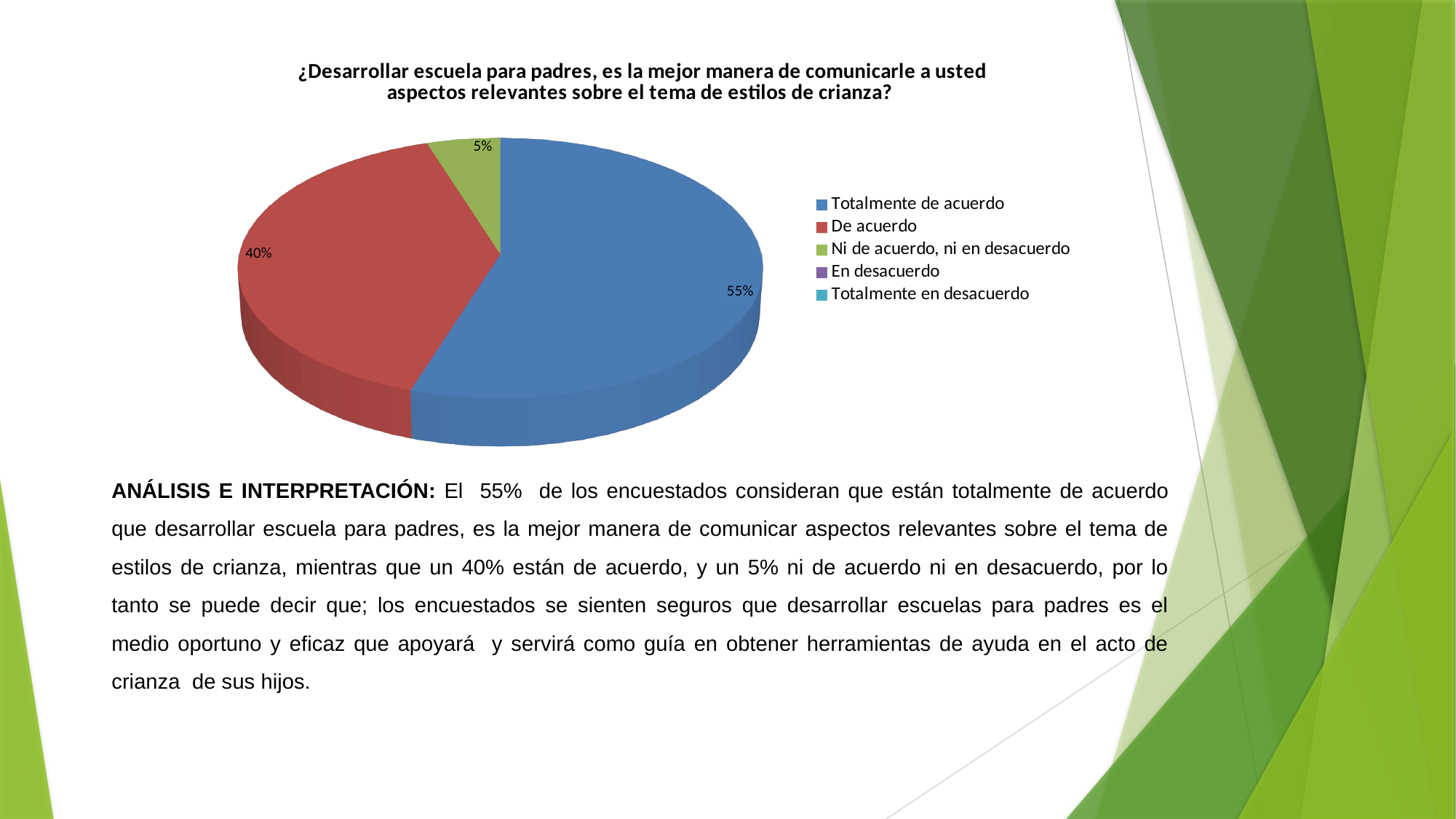
What kind of chart is shown on the slide? Pie chart What percentage of respondents answered "De acuerdo"? 40% What colour is the slice for "Totalmente de acuerdo"? Blue Which category has the largest share of the pie? Totalmente de acuerdo How many entries does the legend list? 5 What is the difference in percentage points between "Totalmente de acuerdo" and "De acuerdo"? 15 How many slices of the pie have a percentage label? 3 What percentage of respondents answered "Totalmente de acuerdo"? 55% Which of the labelled slices has the smallest share of the pie? Ni de acuerdo, ni en desacuerdo Which is larger, the share for "De acuerdo" or the share for "Ni de acuerdo, ni en desacuerdo"? De acuerdo What percentage of respondents answered "Ni de acuerdo, ni en desacuerdo"? 5% What is the combined share of "Totalmente de acuerdo" and "De acuerdo"? 95%